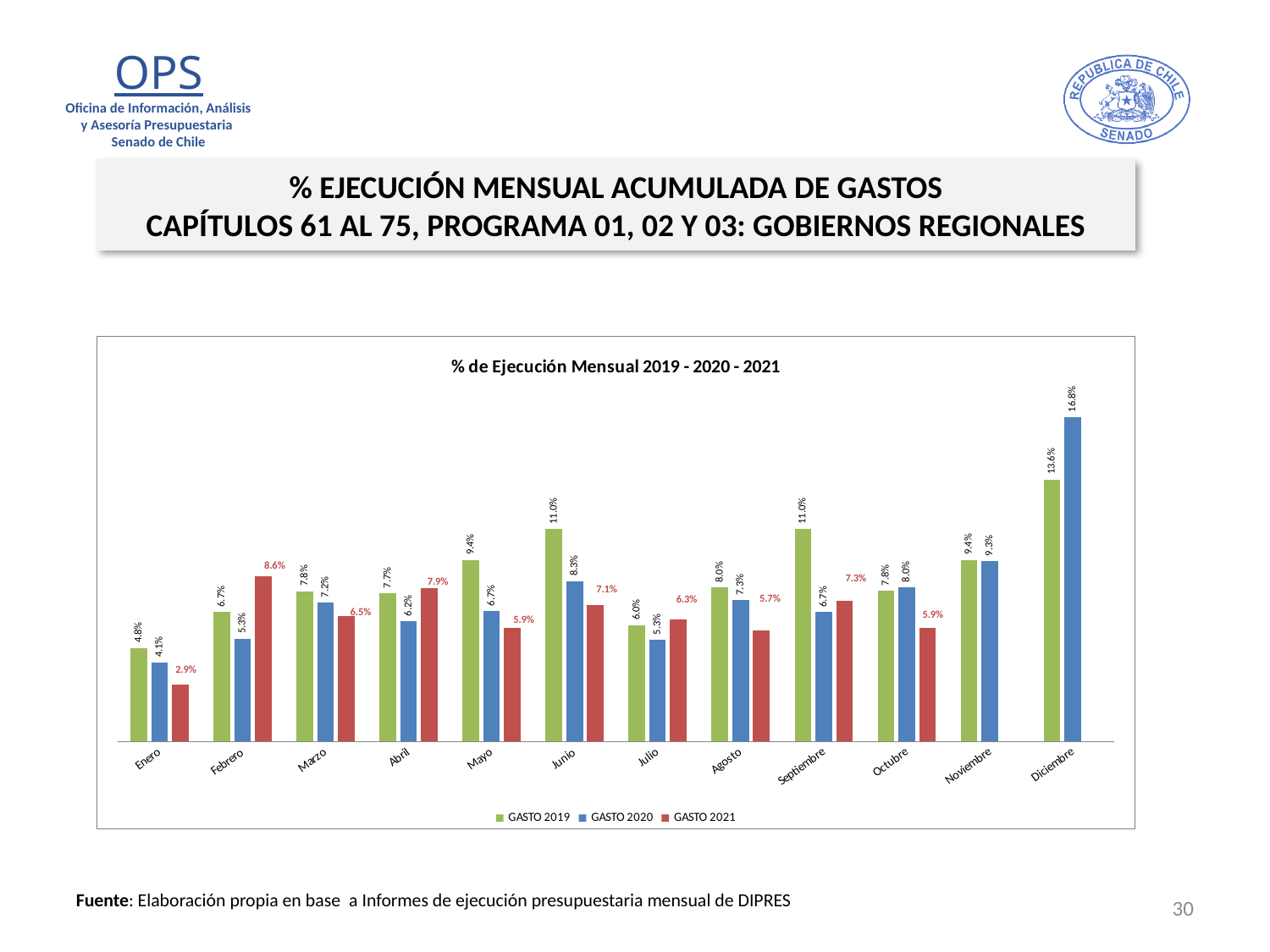
Which month has the lowest GASTO 2021 value? Enero What kind of chart is shown on the slide? Bar chart What is the GASTO 2020 value for Diciembre? 16.8% How many series does the legend list? 3 What is the GASTO 2021 value for Febrero? 8.6% What is the title of the chart? % de Ejecución Mensual 2019 - 2020 - 2021 What is the difference between the GASTO 2020 and GASTO 2019 values for Diciembre? 3.2% How many months are shown on the x axis? 12 What is the GASTO 2021 value for Enero? 2.9% Which is larger for Octubre: GASTO 2019 or GASTO 2020? GASTO 2020 What is the GASTO 2019 value for Septiembre? 11.0% Which month has the highest GASTO 2020 value? Diciembre